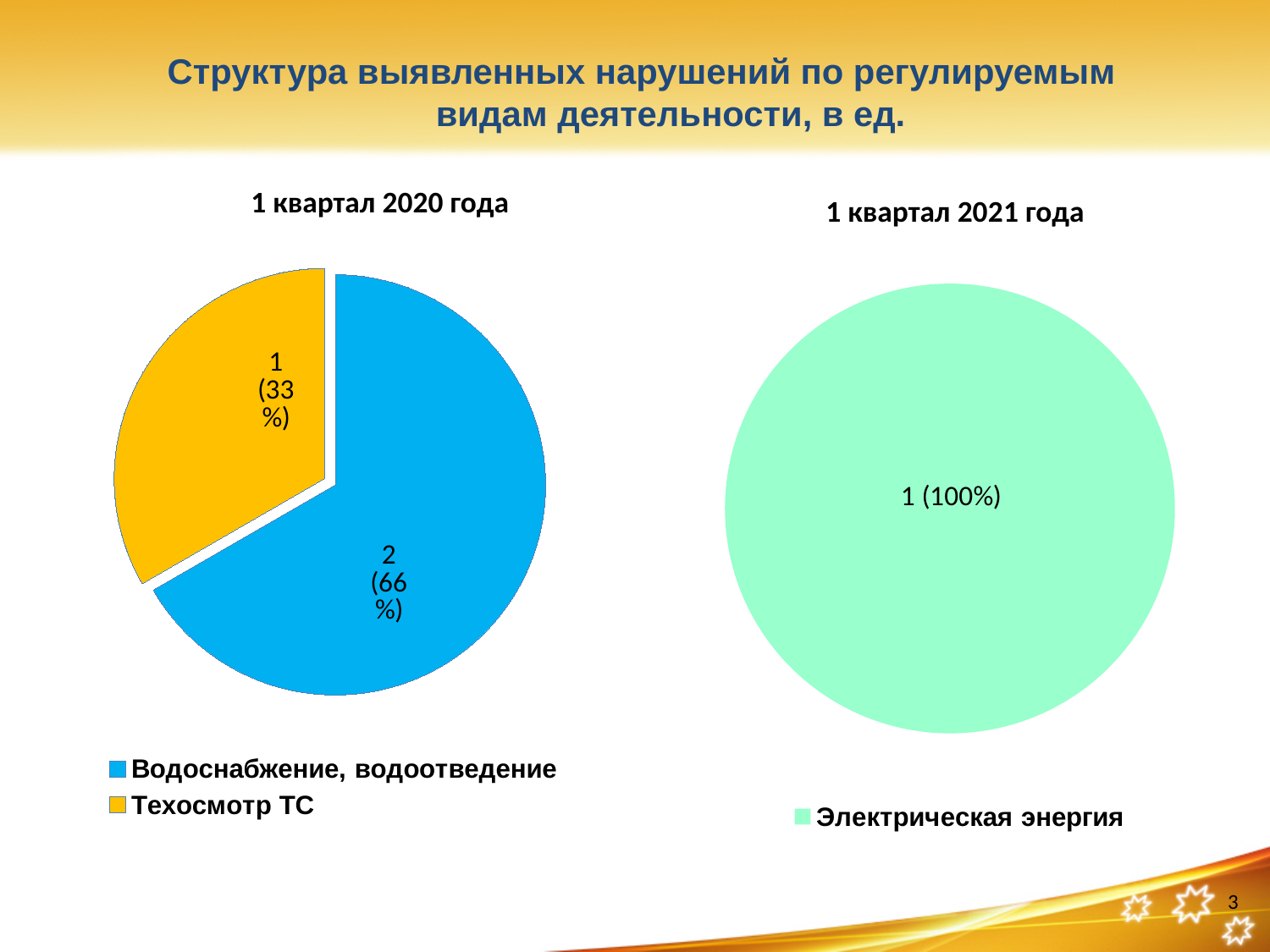
In the '1 квартал 2020 года' chart, what share of the pie does Водоснабжение, водоотведение take? 66% In the '1 квартал 2020 года' chart, what share of the pie does Техосмотр ТС take? 33% In the '1 квартал 2020 года' chart, what value is shown for Водоснабжение, водоотведение? 2 In the '1 квартал 2020 года' chart, which category has the largest slice? Водоснабжение, водоотведение In the '1 квартал 2020 года' chart, what colour is the slice for Техосмотр ТС? Yellow In the '1 квартал 2020 года' chart, what is the difference between the values for Водоснабжение, водоотведение and Техосмотр ТС? 1 What kind of chart is the '1 квартал 2021 года' chart? Pie chart How many categories does the '1 квартал 2020 года' chart show? 2 In the '1 квартал 2020 года' chart, what value is shown for Техосмотр ТС? 1 In the '1 квартал 2020 года' chart, which category has the smallest slice? Техосмотр ТС In the '1 квартал 2021 года' chart, what value is shown for Электрическая энергия? 1 In the '1 квартал 2021 года' chart, what share of the pie does Электрическая энергия take? 100%